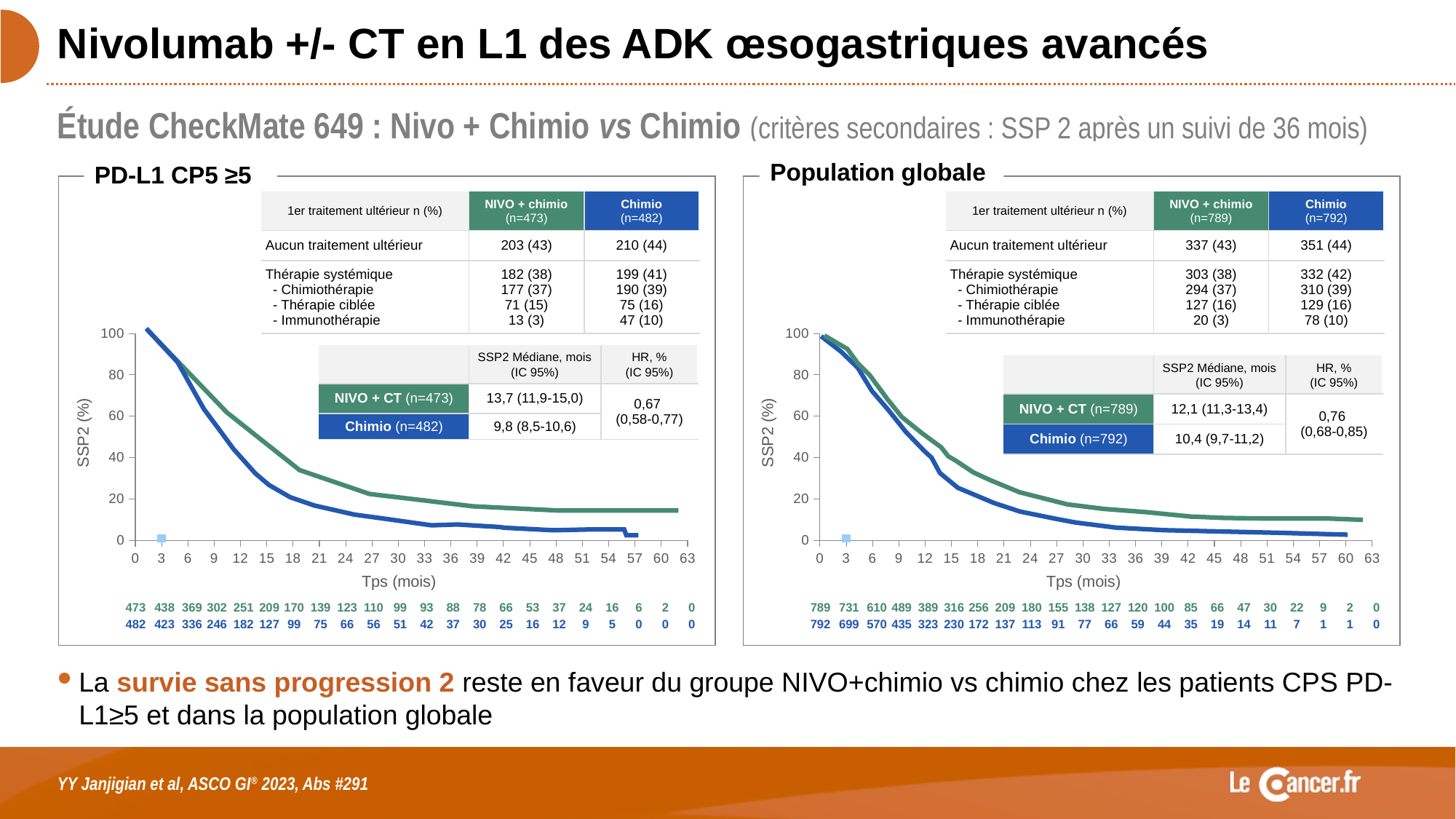
In the 'Population globale' chart, what is the hazard ratio (HR) with its 95% CI? 0,76 (0,68-0,85) In the 'PD-L1 CP5 ≥5' chart, what is the difference in median SSP2 (months) between NIVO + CT and Chimio? 3,9 In the 'PD-L1 CP5 ≥5' chart, is the SSP2 value for the NIVO + CT curve at 24 months greater or less than 20%? greater How do the SSP2 curves in the 'PD-L1 CP5 ≥5' chart change as time (months) increases? They fall In the 'PD-L1 CP5 ≥5' chart, what is the median SSP2 in months for NIVO + CT? 13,7 In the 'Population globale' chart, how many patients were at risk in the Chimio group at 36 months? 59 In the 'Population globale' chart, what is the median SSP2 in months for NIVO + CT? 12,1 What kind of chart is shown in the 'PD-L1 CP5 ≥5' panel? line chart In the 'Population globale' chart, which group has the higher median SSP2, NIVO + CT or Chimio? NIVO + CT In the 'PD-L1 CP5 ≥5' chart, what is the hazard ratio (HR) shown? 0,67 In the 'Population globale' chart, is the SSP2 value for the Chimio curve at 24 months greater or less than 20%? less In the 'PD-L1 CP5 ≥5' chart, what is the median SSP2 in months for Chimio? 9,8